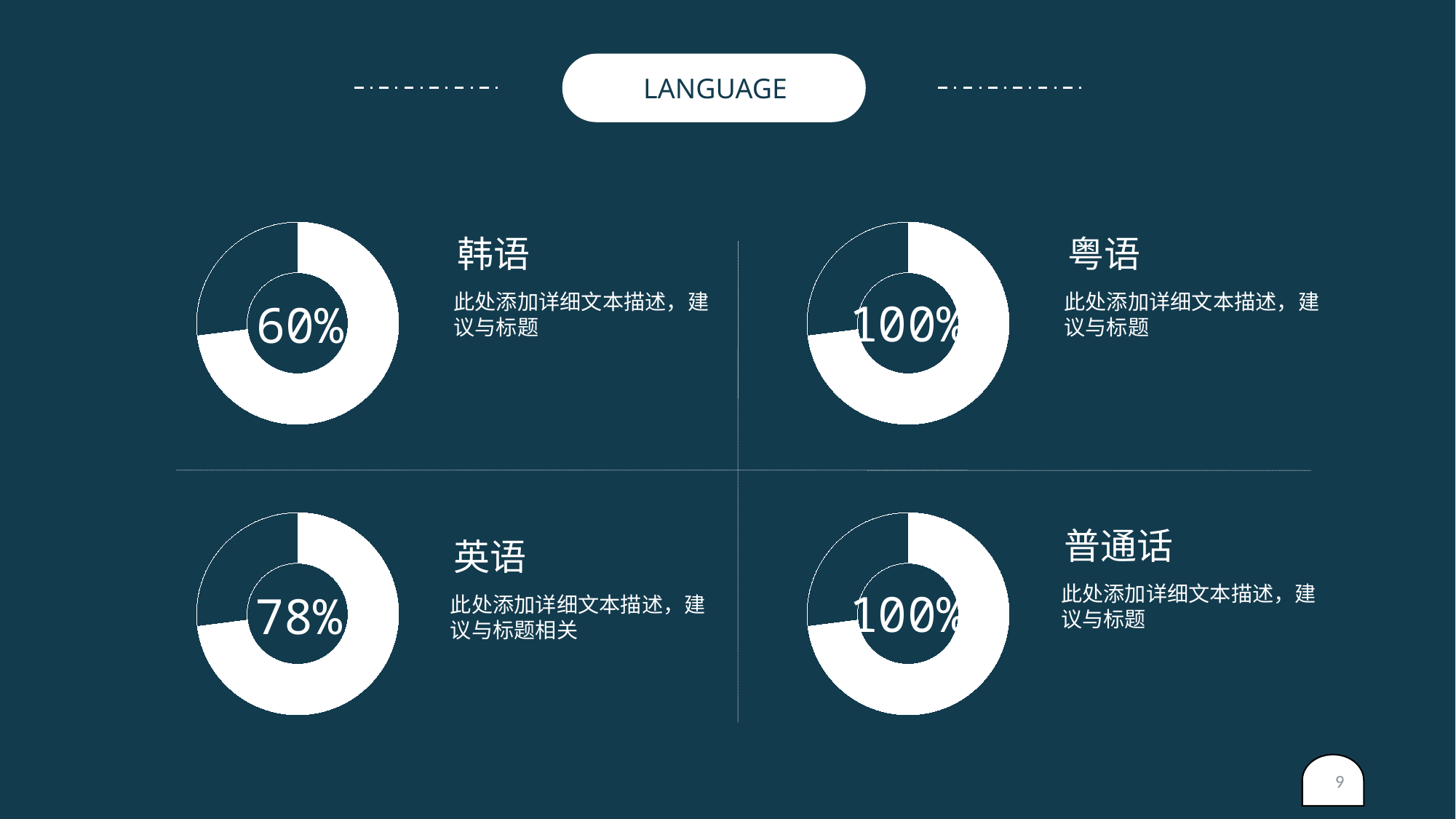
How many languages show a value of 100%? 2 What percentage is shown in the centre of the 粤语 (top-right) donut chart? 100% What is the title shown at the top of the slide? LANGUAGE Which is larger, the percentage for 韩语 or the percentage for 英语? 英语 Which language has the lowest percentage shown on the slide? 韩语 What percentage is shown in the centre of the 普通话 (bottom-right) donut chart? 100% What kind of chart is used for each language on the slide? Donut chart How many donut charts are on the slide? 4 What is the difference between the percentage for 英语 and the percentage for 韩语? 18% What percentage is shown in the centre of the 韩语 (top-left) donut chart? 60% What is the difference between the percentage for 粤语 and the percentage for 韩语? 40% What percentage is shown in the centre of the 英语 (bottom-left) donut chart? 78%